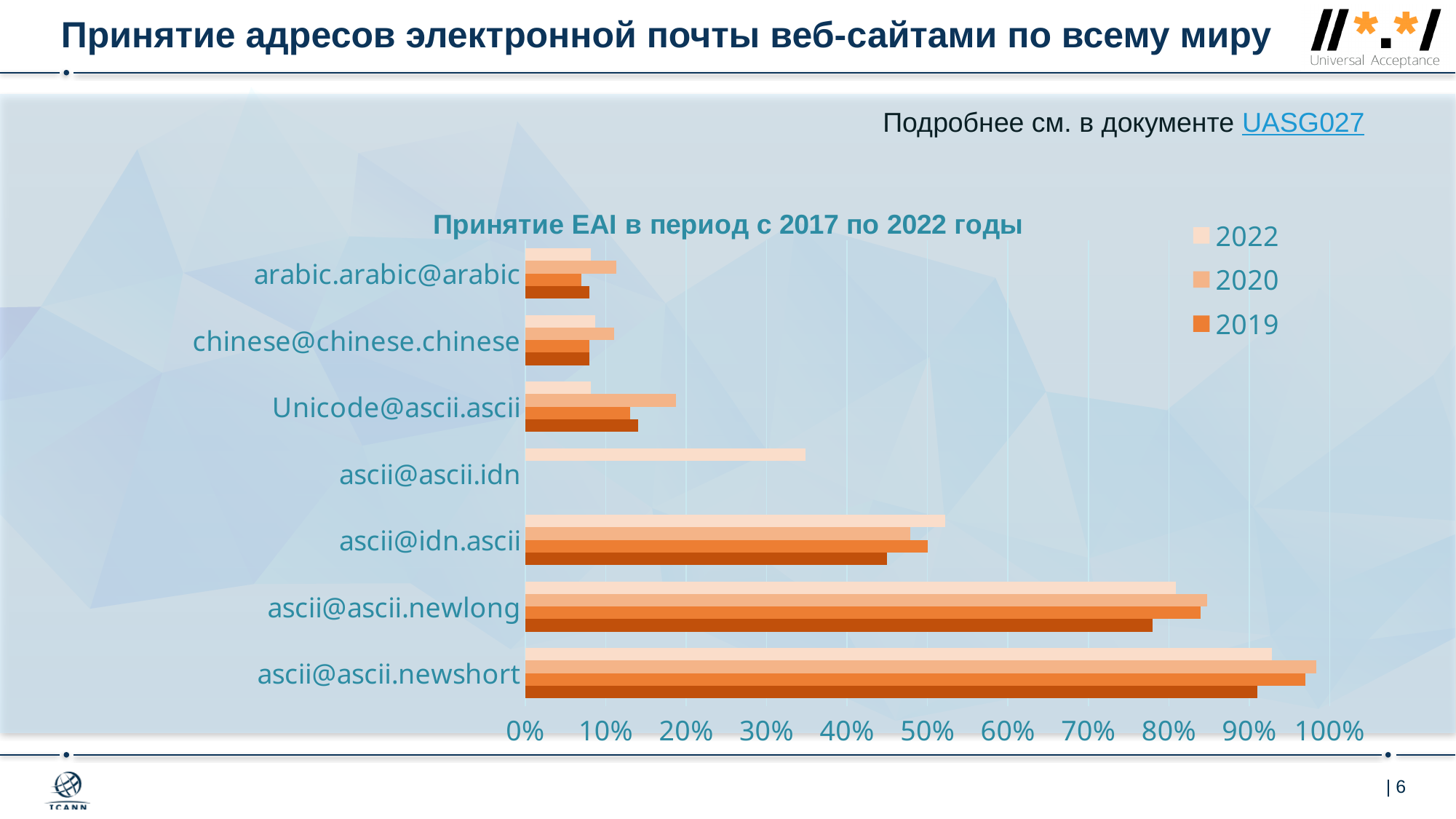
For ascii@ascii.newshort, which is larger: the 2020 value or the 2019 value? 2020 Which category has the highest value for the 2020 series? ascii@ascii.newshort For Unicode@ascii.ascii, which is larger: the 2020 value or the 2022 value? 2020 How many email address categories are shown on the chart? 7 How many series does the legend of the chart list? 3 Is the 2019 value for ascii@idn.ascii greater or less than 40%? greater Which category has the highest value for the 2019 series? ascii@ascii.newshort Is the 2020 value for ascii@ascii.newshort greater or less than 90%? greater Is the 2019 value for ascii@ascii.newlong greater or less than 70%? greater What kind of chart is shown on the slide? Bar chart What is the title of the chart? Принятие EAI в период с 2017 по 2022 годы